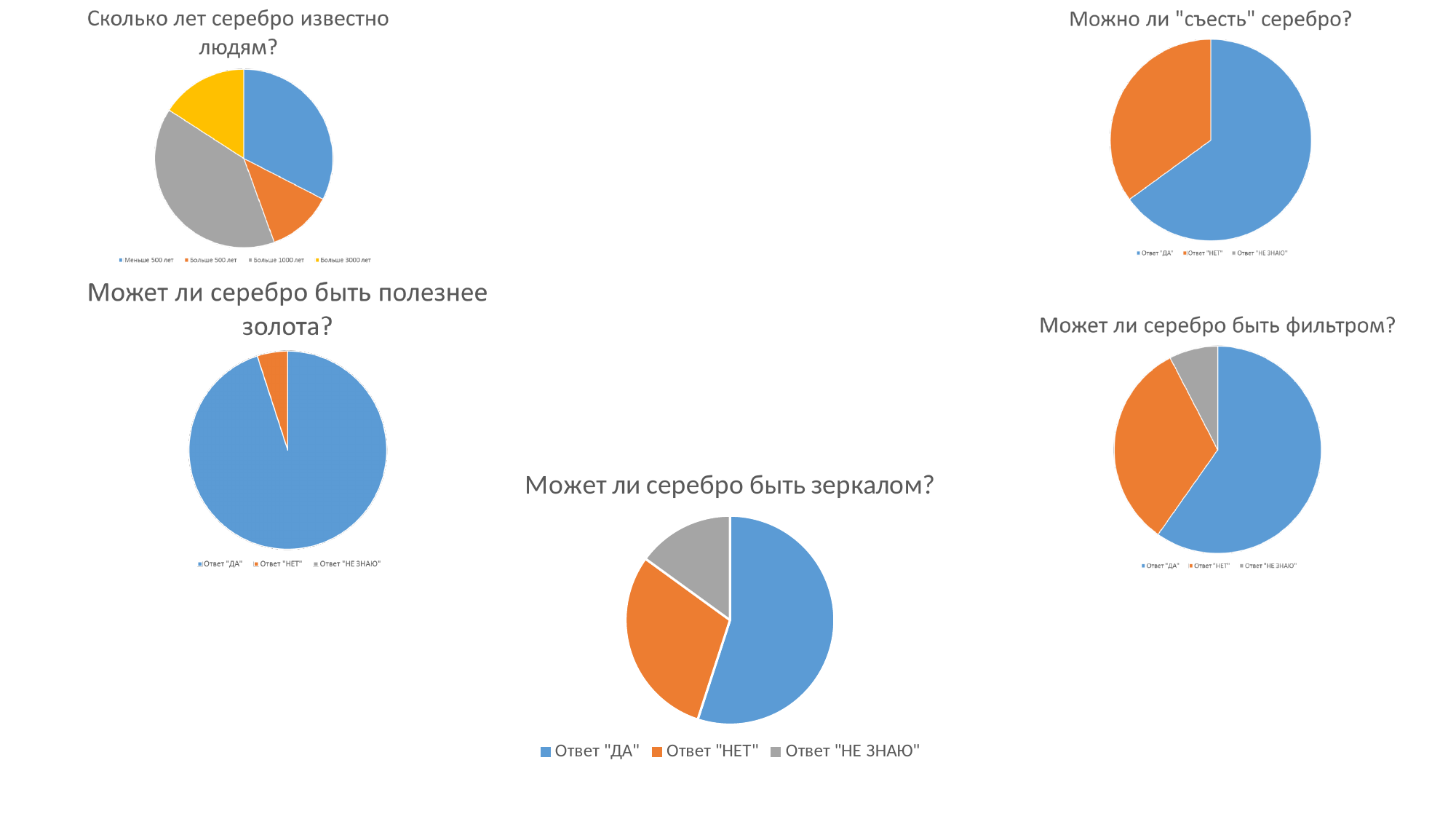
In the chart "Может ли серебро быть фильтром?", which answer has the smallest slice? Ответ "НЕ ЗНАЮ" In the chart "Может ли серебро быть полезнее золота?", which answer has the largest slice? Ответ "ДА" In the chart "Сколько лет серебро известно людям?", which category has the largest slice? Больше 1000 лет How many categories does the legend of "Сколько лет серебро известно людям?" list? 4 In the chart "Может ли серебро быть фильтром?", which slice is larger: Ответ "ДА" or Ответ "НЕТ"? Ответ "ДА" In the chart "Может ли серебро быть зеркалом?", which answer has the smallest slice? Ответ "НЕ ЗНАЮ" In the chart "Может ли серебро быть зеркалом?", which answer has the largest slice? Ответ "ДА" In the chart "Сколько лет серебро известно людям?", what colour is the slice for "Больше 3000 лет"? yellow How many entries does the legend of "Можно ли "съесть" серебро?" list? 3 What kind of chart is "Может ли серебро быть зеркалом?"? pie chart How many charts are shown on the slide? 5